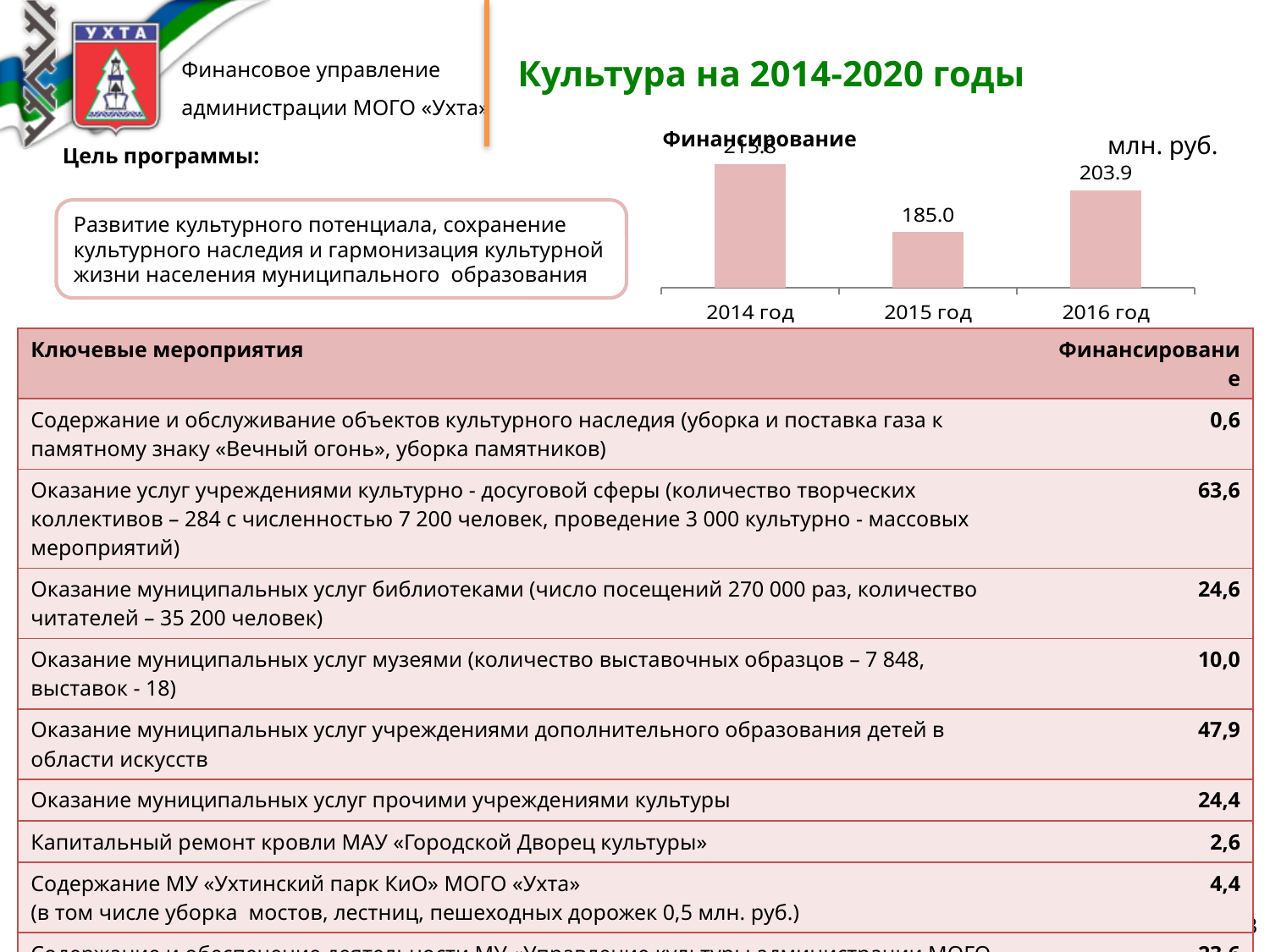
What is the value for 2015 год in the Финансирование chart? 185.0 What unit is indicated for the values in the Финансирование chart? млн. руб. Which year has the highest bar in the Финансирование chart? 2014 год How many years are shown in the Финансирование chart? 3 Which year has the lowest bar in the Финансирование chart? 2015 год What kind of chart is the Финансирование chart? bar chart What is the title of the chart on the slide? Финансирование Does the value rise or fall from 2015 год to 2016 год in the Финансирование chart? rise Does the value rise or fall from 2014 год to 2015 год in the Финансирование chart? fall What is the difference between the values for 2016 год and 2015 год in the Финансирование chart? 18.9 Which is larger in the Финансирование chart, the value for 2015 год or 2016 год? 2016 год What is the value for 2016 год in the Финансирование chart? 203.9